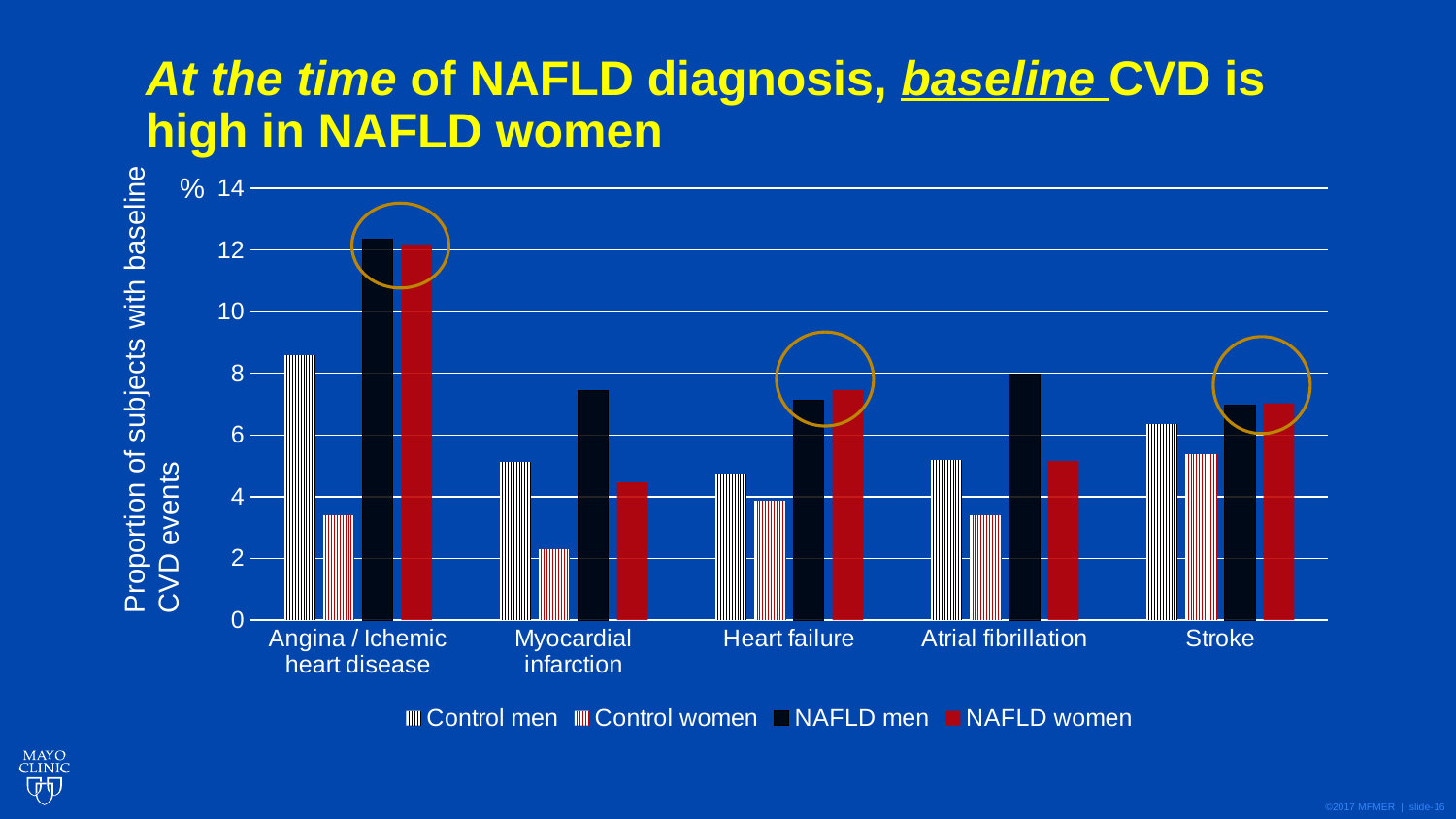
Is the value for NAFLD men in Angina / Ichemic heart disease greater or less than 10? greater For Angina / Ichemic heart disease, which is larger: Control men or Control women? Control men What is the label of the y axis? Proportion of subjects with baseline CVD events In which category is the Control women bar the lowest? Myocardial infarction What kind of chart is shown on the slide? Bar chart How many CVD event categories are shown on the x axis? 5 Is the value for NAFLD men in Atrial fibrillation greater or less than 6? greater Is the value for Control men in Stroke greater or less than 8? less How many series does the legend list? 4 In which category is the NAFLD women bar the highest? Angina / Ichemic heart disease For Myocardial infarction, which is larger: NAFLD men or NAFLD women? NAFLD men